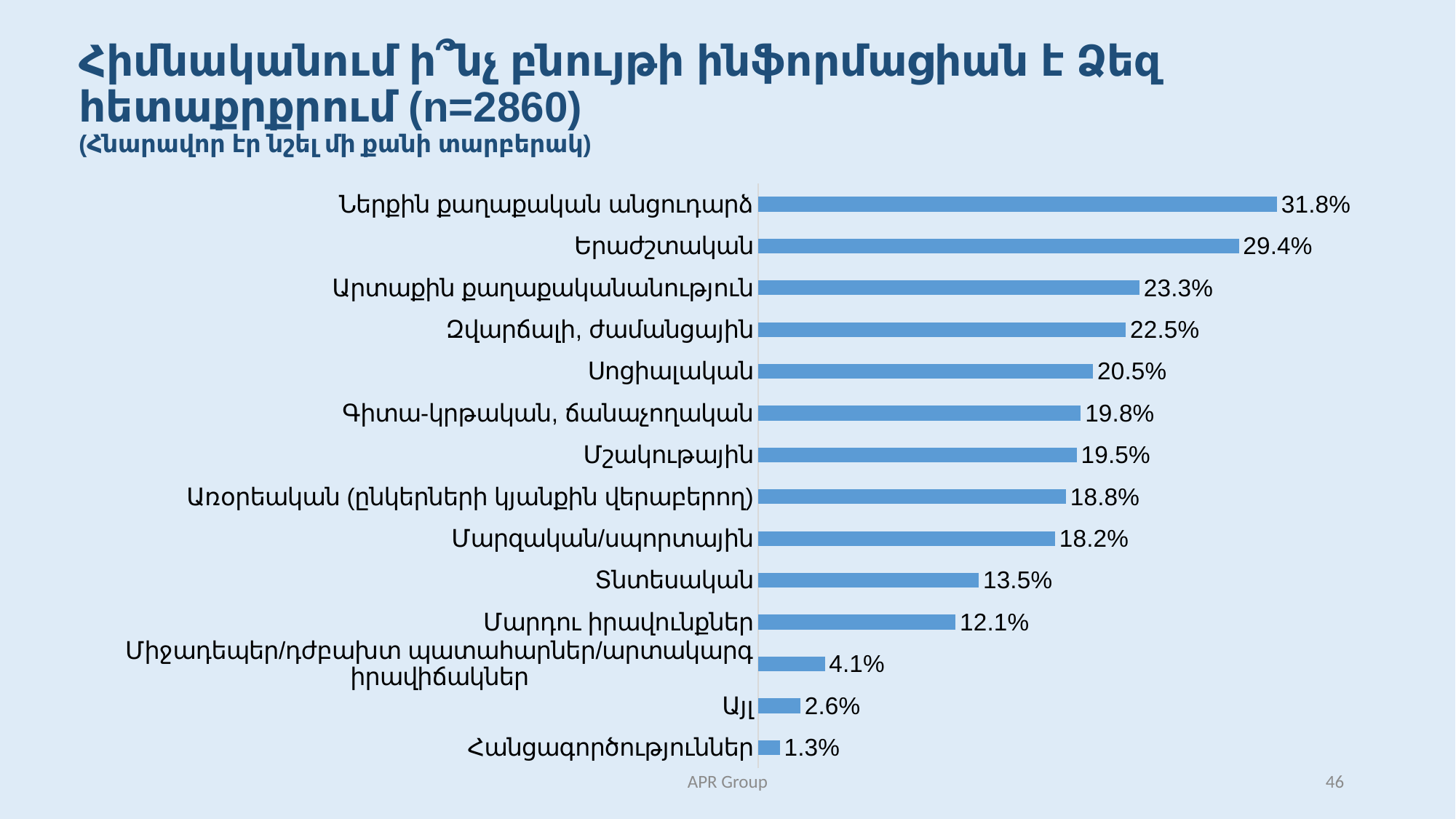
What is the value for Ներքին քաղաքական անցուդարձ? 31.8% Which category has the highest value? Ներքին քաղաքական անցուդարձ What sample size (n) is stated in the slide title? n=2860 What is the difference between the values for Ներքին քաղաքական անցուդարձ and Երաժշտական? 2.4% What is the difference between the values for Սոցիալական and Մարդու իրավունքներ? 8.4% What is the value for Մշակութային? 19.5% What kind of chart is shown on the slide? Bar chart What is the value for Այլ? 2.6% What is the value for Տնտեսական? 13.5% How many categories are shown in the chart? 14 Which is larger, the value for Արտաքին քաղաքականանություն or the value for Մարզական/սպորտային? Արտաքին քաղաքականանություն Which category has the lowest value? Հանցագործություններ